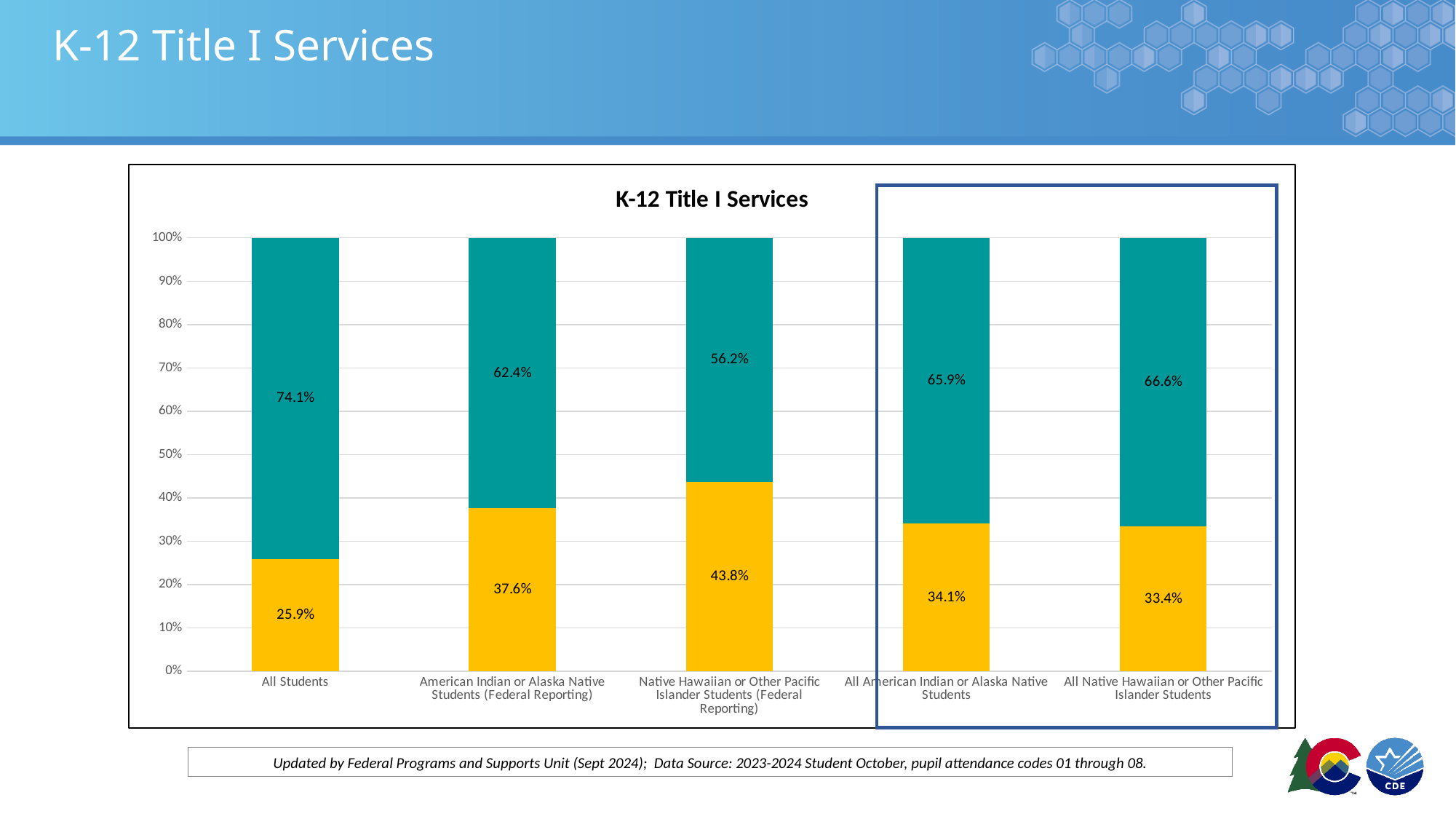
Which category has the largest yellow segment? Native Hawaiian or Other Pacific Islander Students (Federal Reporting) What is the value of the yellow segment for All American Indian or Alaska Native Students? 34.1% What is the total of the stacked bar for All American Indian or Alaska Native Students? 100% What is the value of the teal segment for Native Hawaiian or Other Pacific Islander Students (Federal Reporting)? 56.2% Which is larger: the teal segment for All Students or the teal segment for American Indian or Alaska Native Students (Federal Reporting)? All Students What type of chart is shown on the slide? stacked bar chart What is the value of the teal segment for All Native Hawaiian or Other Pacific Islander Students? 66.6% What is the difference between the yellow segment for American Indian or Alaska Native Students (Federal Reporting) and the yellow segment for All Students? 11.7% What is the value of the yellow segment for All Students? 25.9% What is the title of the chart? K-12 Title I Services How many categories are shown on the x axis of the chart? 5 Which category has the smallest yellow segment? All Students